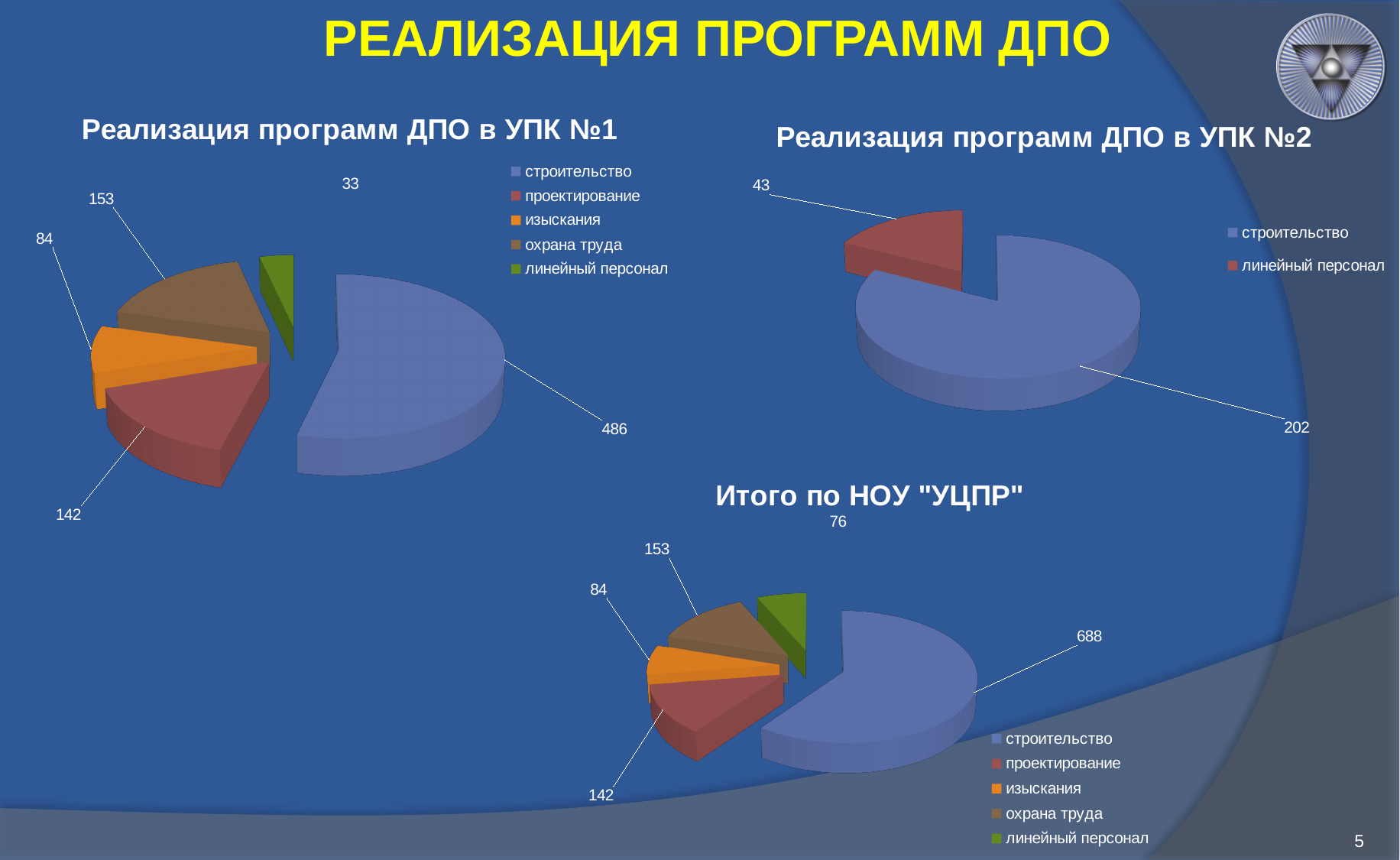
In the chart titled "Итого по НОУ "УЦПР"", which is larger: охрана труда or проектирование? охрана труда In the chart titled "Итого по НОУ "УЦПР"", what is the value for строительство? 688 In the chart titled "Реализация программ ДПО в УПК №2", what is the value for линейный персонал? 43 What kind of chart is "Реализация программ ДПО в УПК №1"? pie chart In the chart titled "Реализация программ ДПО в УПК №1", what is the value for охрана труда? 153 How many series does the legend list in the chart titled "Реализация программ ДПО в УПК №2"? 2 In the chart titled "Реализация программ ДПО в УПК №1", what is the value for строительство? 486 How many slices does the chart titled "Итого по НОУ "УЦПР"" have? 5 In the chart titled "Реализация программ ДПО в УПК №1", what is the difference between проектирование and изыскания? 58 In the chart titled "Реализация программ ДПО в УПК №2", what is the total of all slices? 245 In the chart titled "Реализация программ ДПО в УПК №1", which category has the smallest value? линейный персонал In the chart titled "Итого по НОУ "УЦПР"", what is the value for линейный персонал? 76